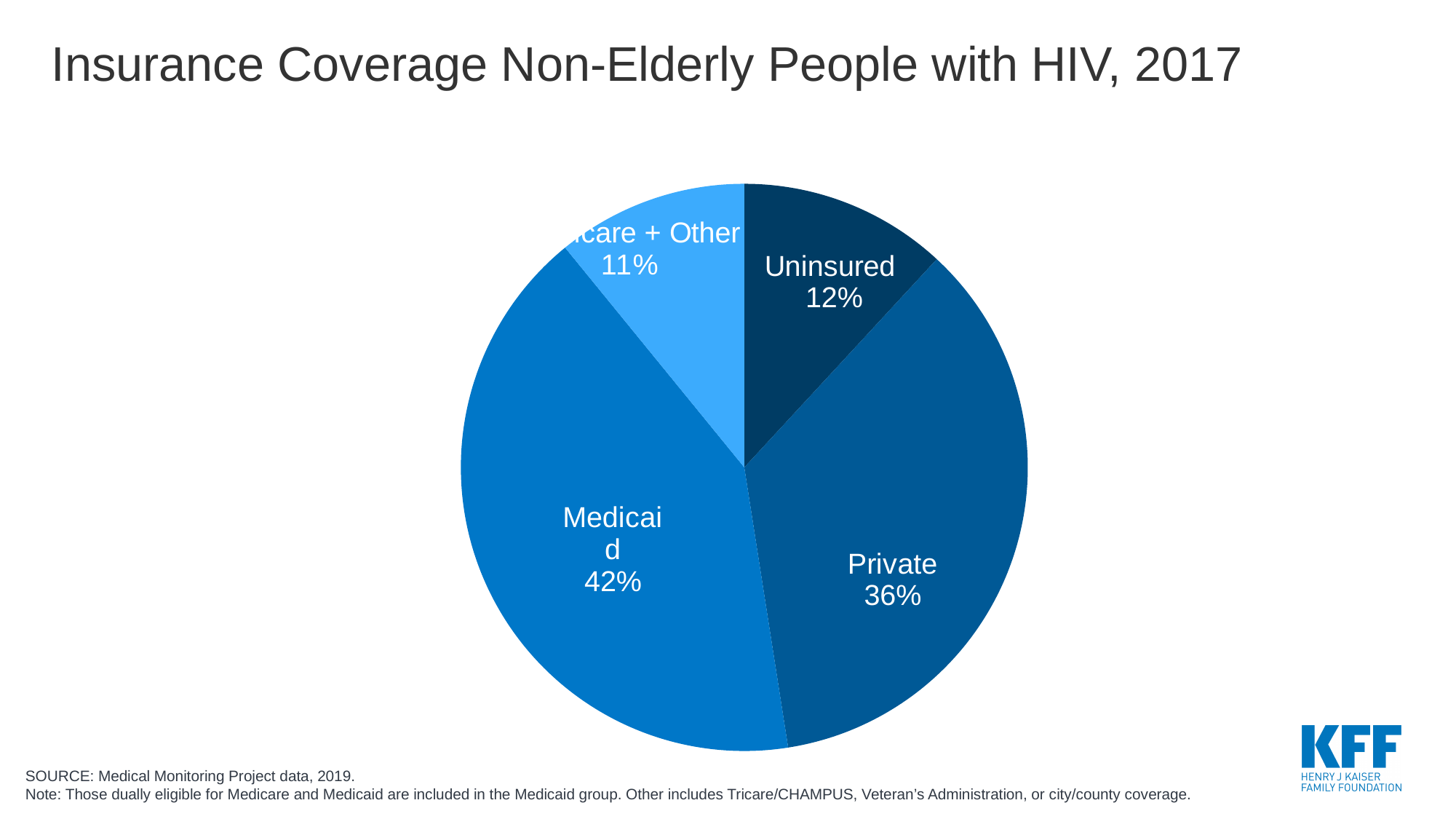
How many slices does the pie chart have? 4 What share of non-elderly people with HIV had private insurance in 2017? 36% What is the title of the chart on the slide? Insurance Coverage Non-Elderly People with HIV, 2017 What kind of chart is shown on the slide? pie chart What is the combined share of the Medicaid and Private slices? 78% Which is larger, the Uninsured share or the Private share? Private What percentage of non-elderly people with HIV were uninsured in 2017? 12% What share of non-elderly people with HIV were covered by Medicaid in 2017? 42% Which coverage category has the smallest share of the pie? Medicare + Other Which coverage category has the largest share of the pie? Medicaid What share is shown for the Medicare + Other slice? 11% What is the difference in percentage points between the Medicaid share and the Private share? 6